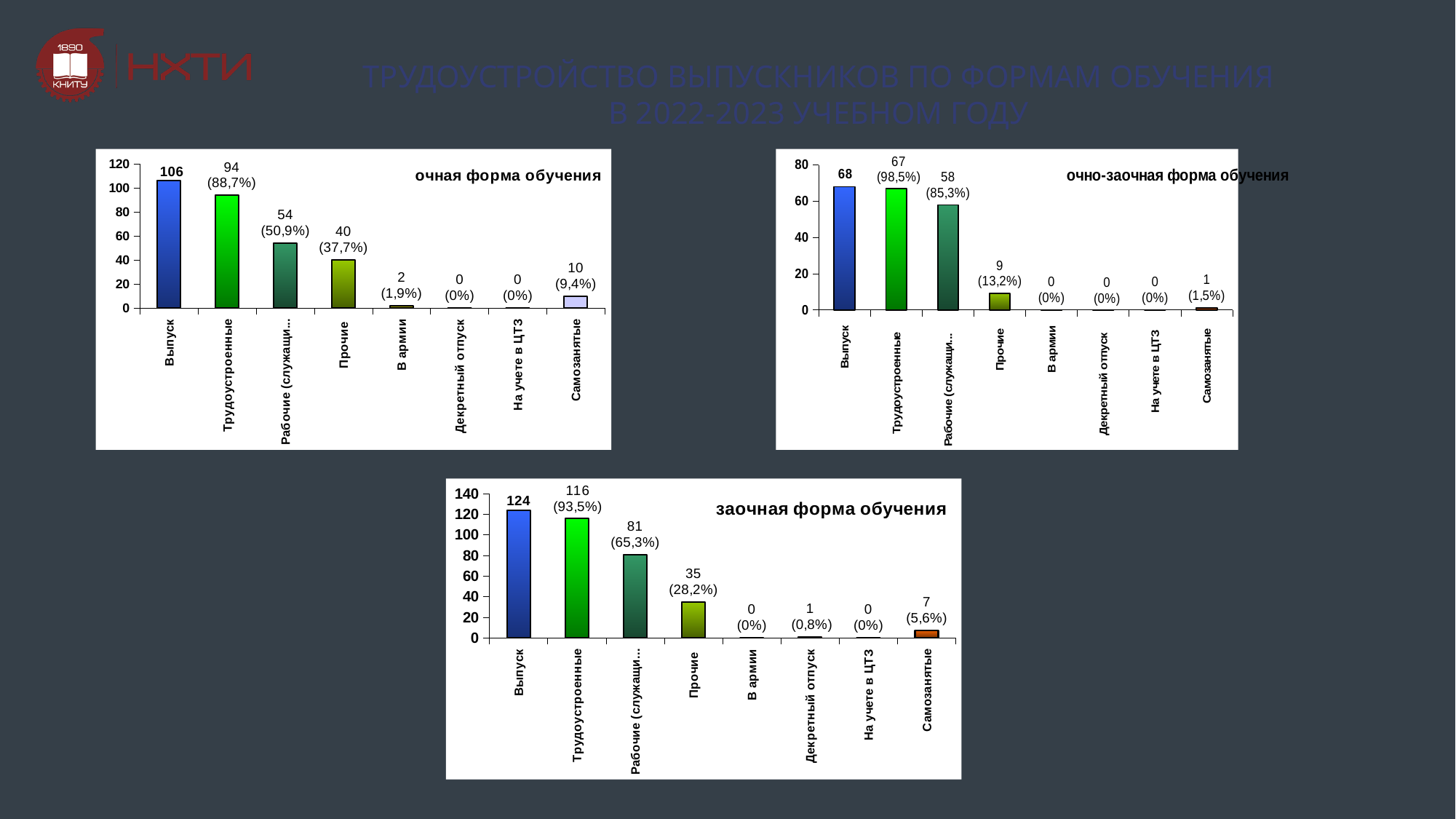
In the chart titled "заочная форма обучения", which is larger: Прочие or Самозанятые? Прочие How many categories are shown on the x axis of the chart titled "заочная форма обучения"? 8 In the chart titled "очно-заочная форма обучения", which category has the highest value? Выпуск In the chart titled "очно-заочная форма обучения", what is the value for Прочие? 9 How many charts are shown on the slide? 3 In the chart titled "очно-заочная форма обучения", what percentage is shown for Самозанятые? 1,5% What type of chart is the one titled "очная форма обучения"? Bar chart In the chart titled "очная форма обучения", what is the value for Выпуск? 106 In the chart titled "заочная форма обучения", what is the value for Декретный отпуск? 1 In the chart titled "очная форма обучения", what is the difference between Выпуск and Трудоустроенные? 12 In the chart titled "очная форма обучения", what percentage is shown for Трудоустроенные? 88,7% In the chart titled "заочная форма обучения", what is the value for Трудоустроенные? 116